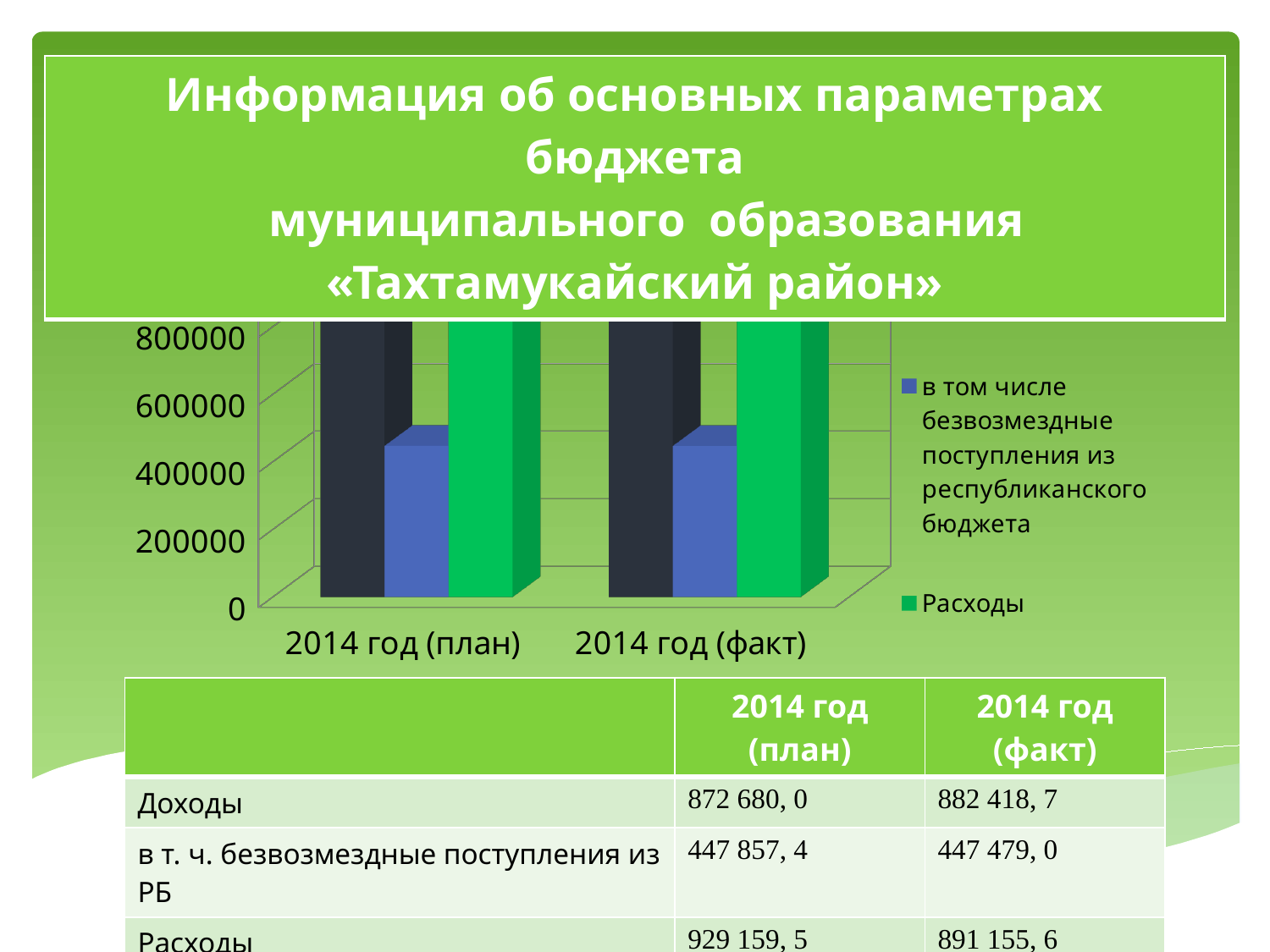
What kind of chart is shown on the slide? bar chart According to the table under the chart, what is the value of Расходы for 2014 год (план)? 929 159, 5 Is the value of the blue bar (безвозмездные поступления из республиканского бюджета) for 2014 год (факт) greater or less than 600000? less For 2014 год (план), which is larger: the green bar (Расходы) or the blue bar (безвозмездные поступления из республиканского бюджета)? Расходы How many categories are shown on the x axis of the chart? 2 According to the table under the chart, what is the value of Доходы for 2014 год (факт)? 882 418, 7 For 2014 год (факт), which series has the lowest bar? в том числе безвозмездные поступления из республиканского бюджета Is the value of the green bar (Расходы) for 2014 год (план) greater or less than 800000? greater Is the value of the blue bar (безвозмездные поступления из республиканского бюджета) for 2014 год (план) greater or less than 400000? greater What are the two categories on the x axis of the chart? 2014 год (план) and 2014 год (факт) What colour are the bars for the series Расходы in the chart? green